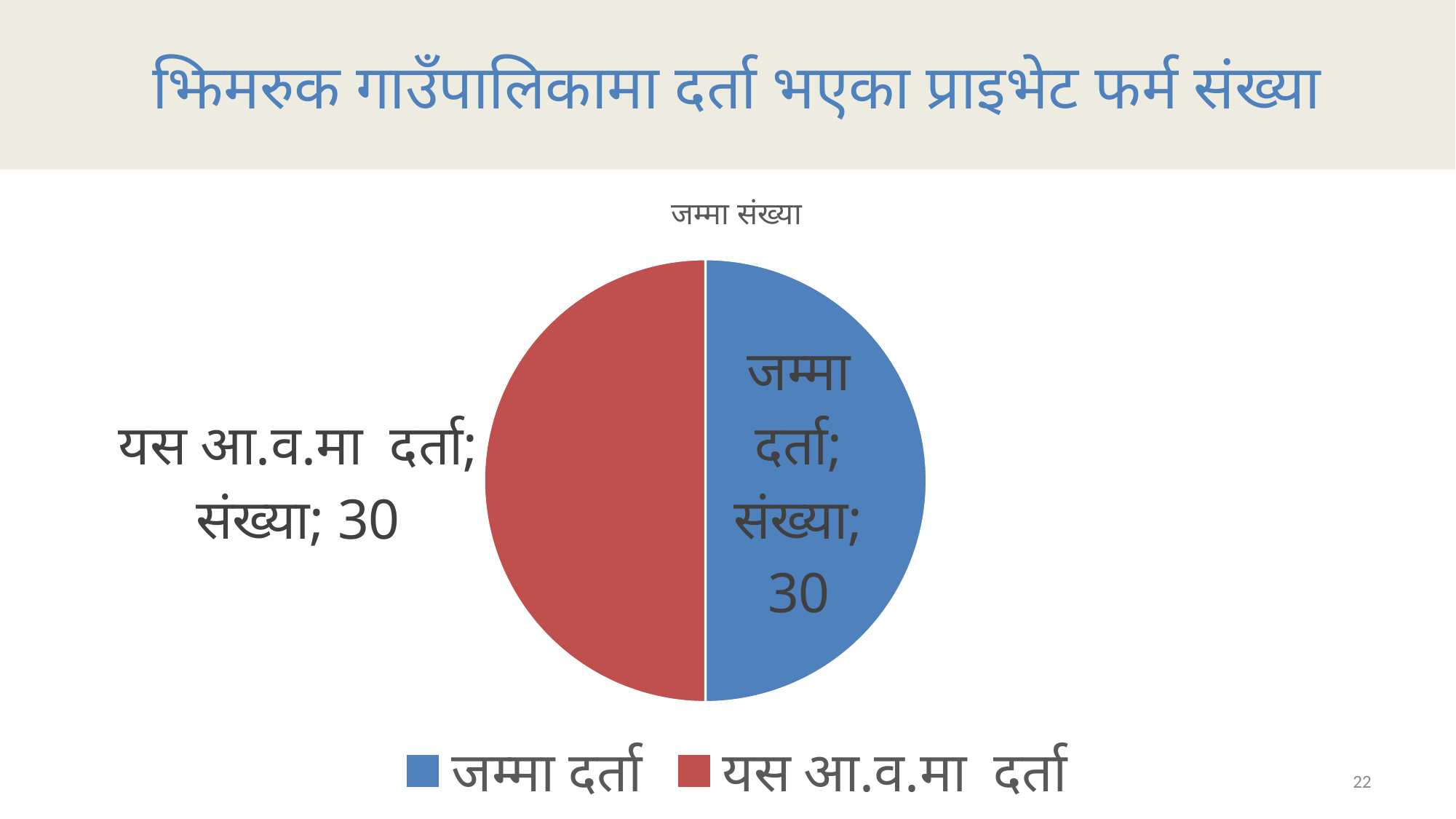
How many slices does the pie chart have? 2 What share of the pie does the यस आ.व.मा दर्ता slice represent? 50% What is the value for जम्मा दर्ता in the pie chart? 30 What kind of chart is shown on the slide? pie chart What share of the pie does the जम्मा दर्ता slice represent? 50% What is the difference between the values for जम्मा दर्ता and यस आ.व.मा दर्ता? 0 What is the title of the chart? जम्मा संख्या Which colour represents यस आ.व.मा दर्ता in the pie chart? red What is the total of the two slices in the pie chart? 60 What is the value for यस आ.व.मा दर्ता in the pie chart? 30 How many entries does the legend list? 2